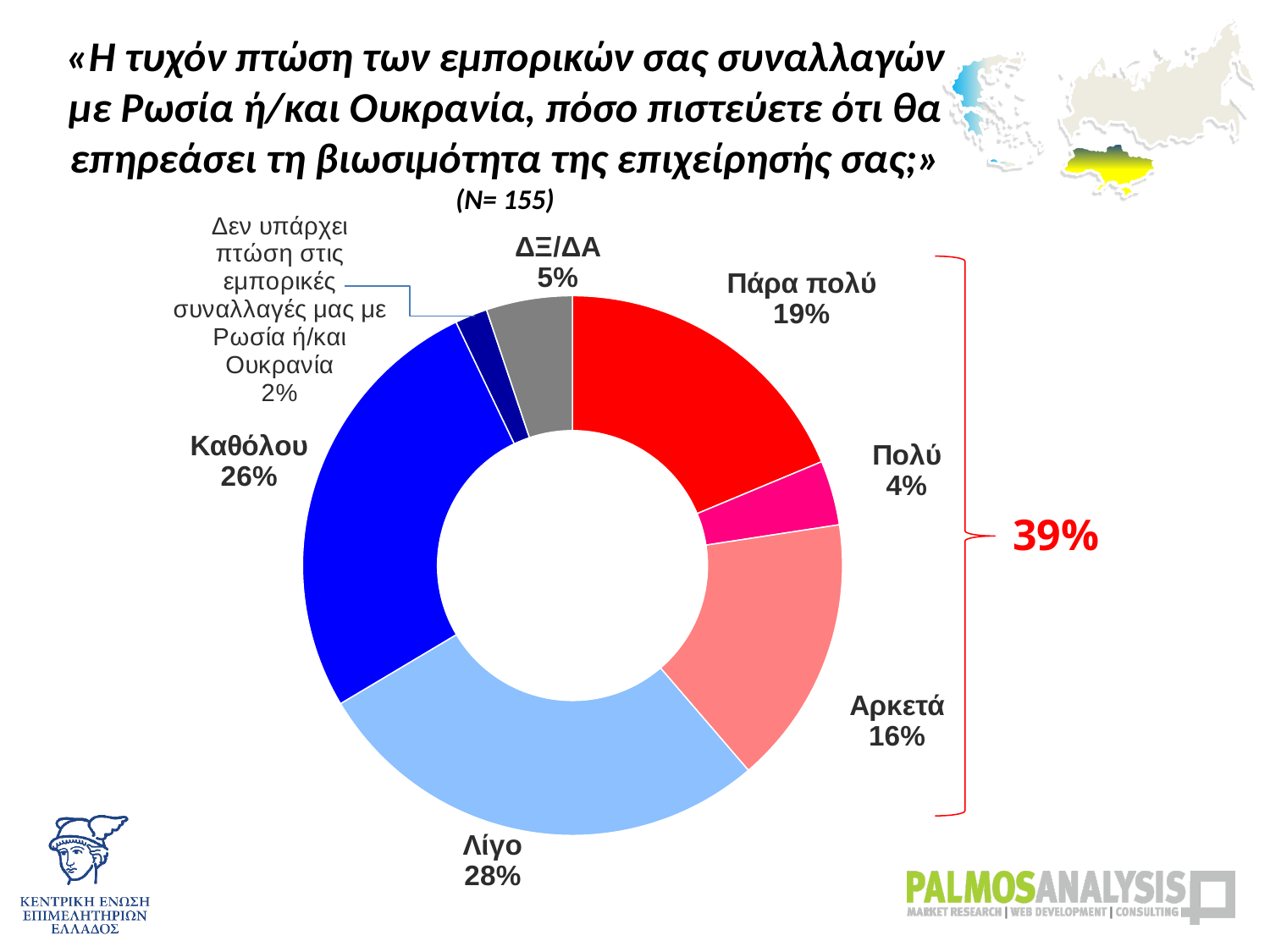
What percentage of respondents answered «Πάρα πολύ»? 19% What percentage of respondents answered «Λίγο»? 28% What is the share for «Καθόλου»? 26% What is the sample size (N) stated on the slide? 155 What kind of chart is shown on the slide? Doughnut (pie) chart How many response categories are shown in the chart? 7 Which response category has the largest share? Λίγο What is the difference in percentage points between «Λίγο» and «Καθόλου»? 2 percentage points What combined percentage is indicated by the red bracket on the right of the chart? 39% What is the share for «ΔΞ/ΔΑ»? 5% Which response category has the smallest share? Δεν υπάρχει πτώση στις εμπορικές συναλλαγές μας με Ρωσία ή/και Ουκρανία Which is larger, the share for «Πάρα πολύ» or the share for «Αρκετά»? Πάρα πολύ